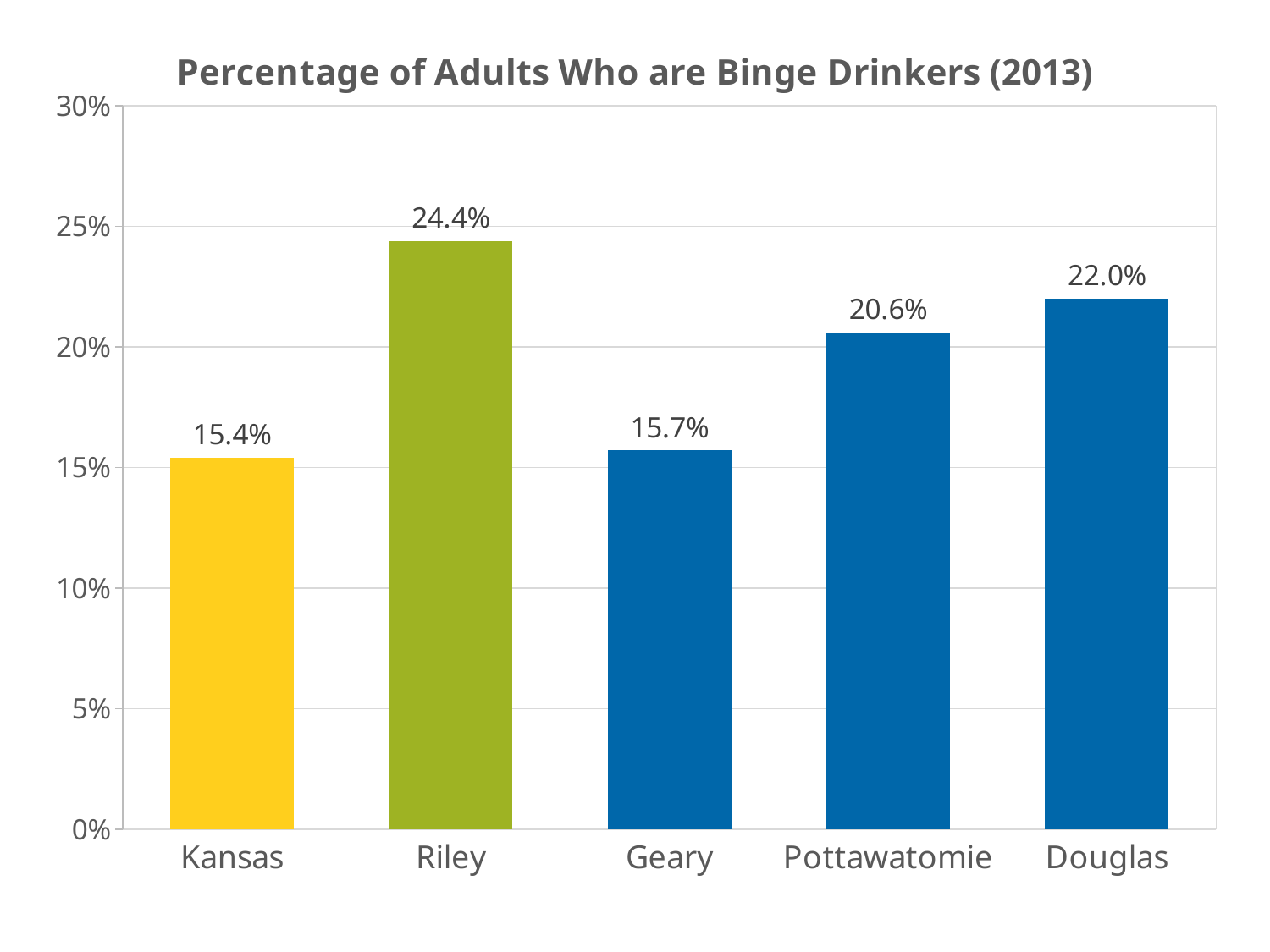
What is the value shown for Pottawatomie? 20.6% What kind of chart is shown on the slide? Bar chart Which has a higher value, Douglas or Pottawatomie? Douglas What is the difference between the values for Douglas and Geary? 6.3% What is the value shown for Kansas? 15.4% Which category has the highest percentage of binge drinkers? Riley Which category has the lowest percentage of binge drinkers? Kansas What is the percentage of adults who are binge drinkers in Riley? 24.4% Is the value for Geary greater or less than 20%? less How many categories are shown on the chart? 5 What is the title of the chart? Percentage of Adults Who are Binge Drinkers (2013) What is the difference between the values for Riley and Kansas? 9.0%